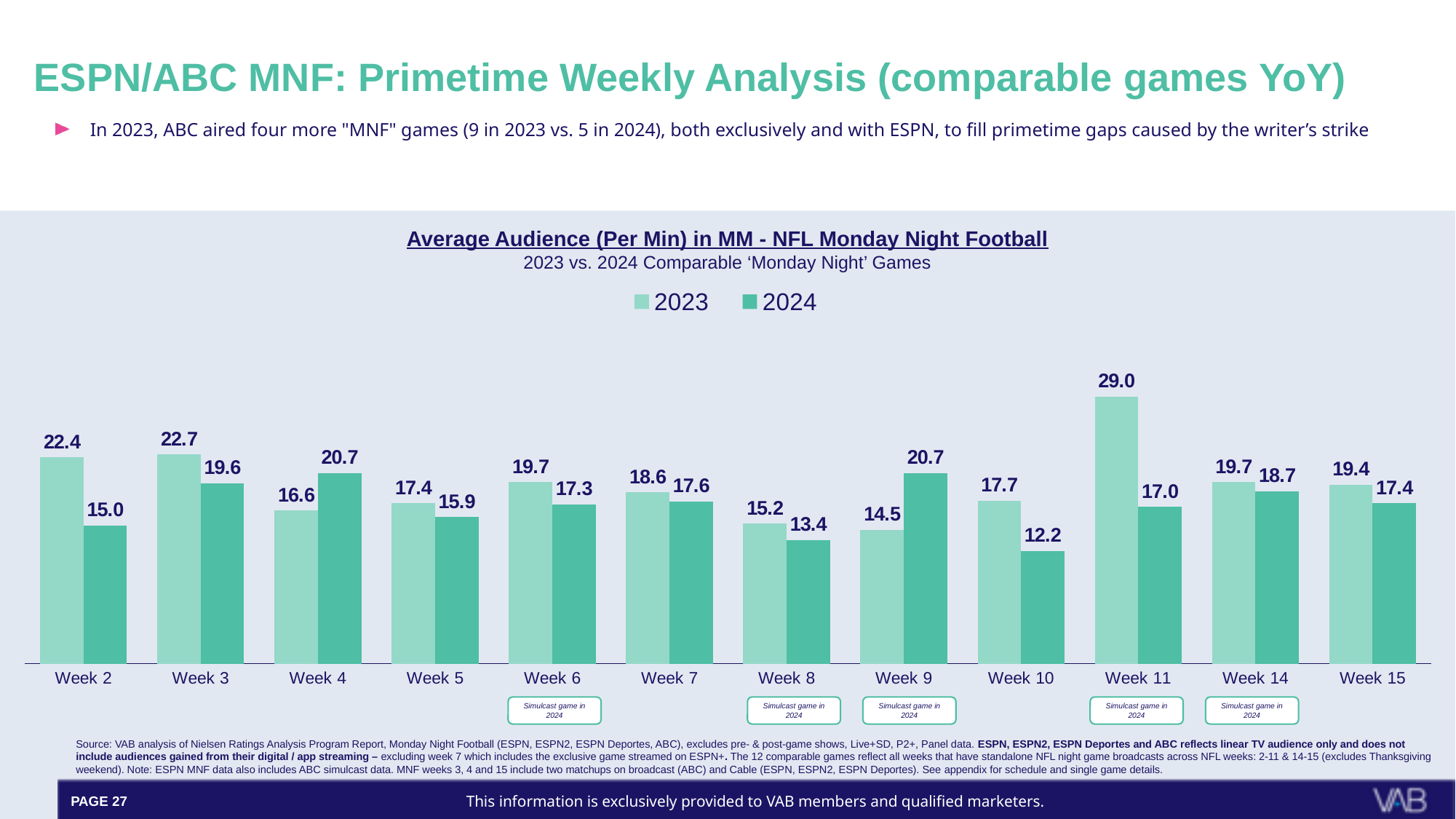
What was the 2024 average audience for Week 4? 20.7 Which week has the highest 2023 value? Week 11 How many weeks are shown on the x axis? 12 For Week 4, which year has the larger value, 2023 or 2024? 2024 Which week has the lowest 2024 value? Week 10 What was the 2024 average audience for Week 10? 12.2 What kind of chart is shown on the slide? Bar chart How many series does the legend list? 2 What is the difference between the 2023 and 2024 values for Week 11? 12.0 What was the 2023 average audience for Week 11? 29.0 Which week has the lowest 2023 value? Week 9 What is the difference between the 2024 and 2023 values for Week 9? 6.2